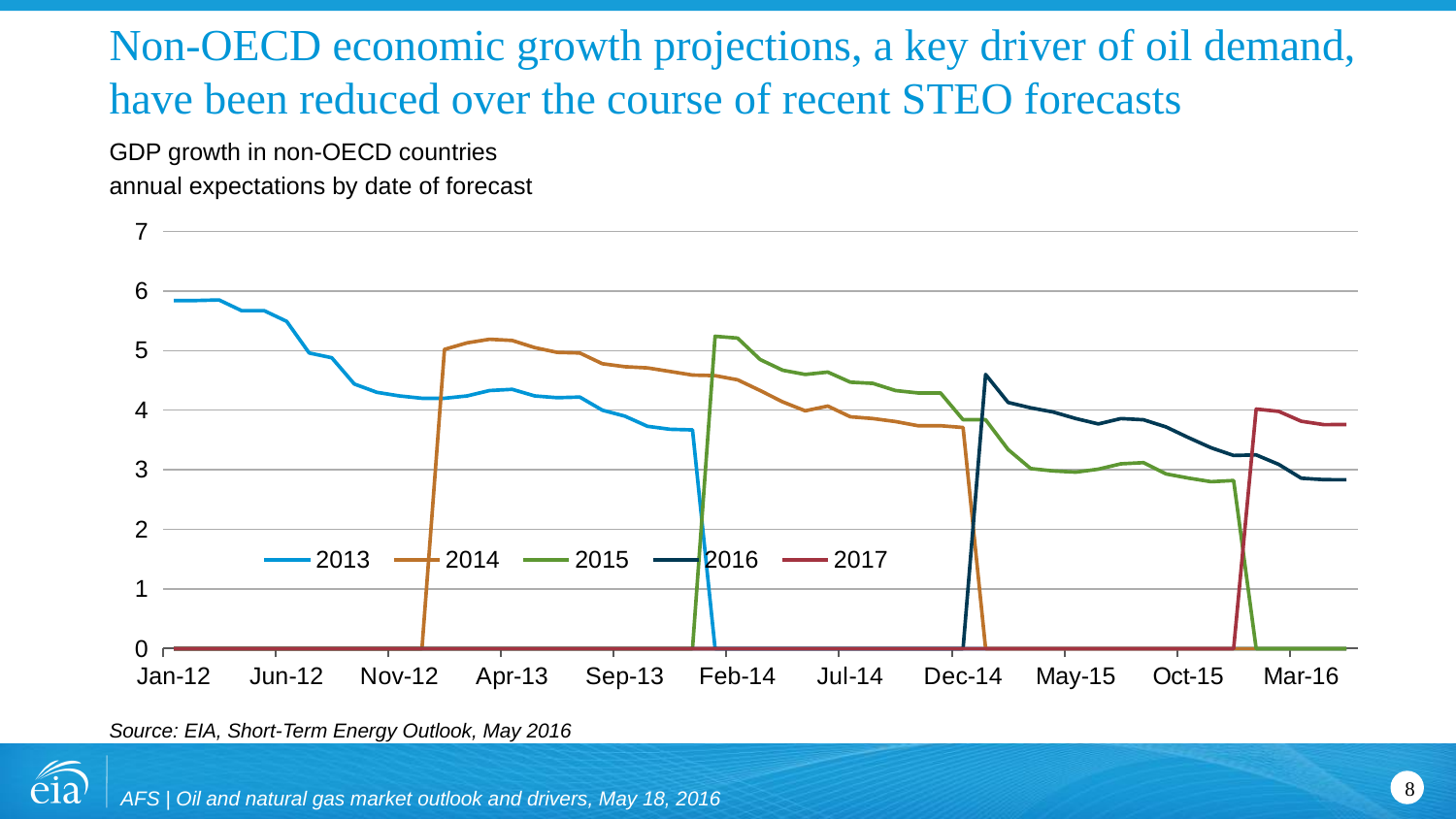
Which years are listed in the chart legend? 2013, 2014, 2015, 2016, 2017 Is the value for the 2013 series at Jan-12 greater or less than 5? greater Does the 2013 series rise or fall from Jan-12 to the end of its forecast period? fall At Mar-16, which series is higher, 2016 or 2017? 2017 Is the value for the 2013 series at Sep-13 greater or less than 5? less Is the value for the 2015 series at Jul-14 greater or less than 4? greater What kind of chart is shown on the slide? line chart What is the subtitle of the chart? GDP growth in non-OECD countries annual expectations by date of forecast How many series does the legend list? 5